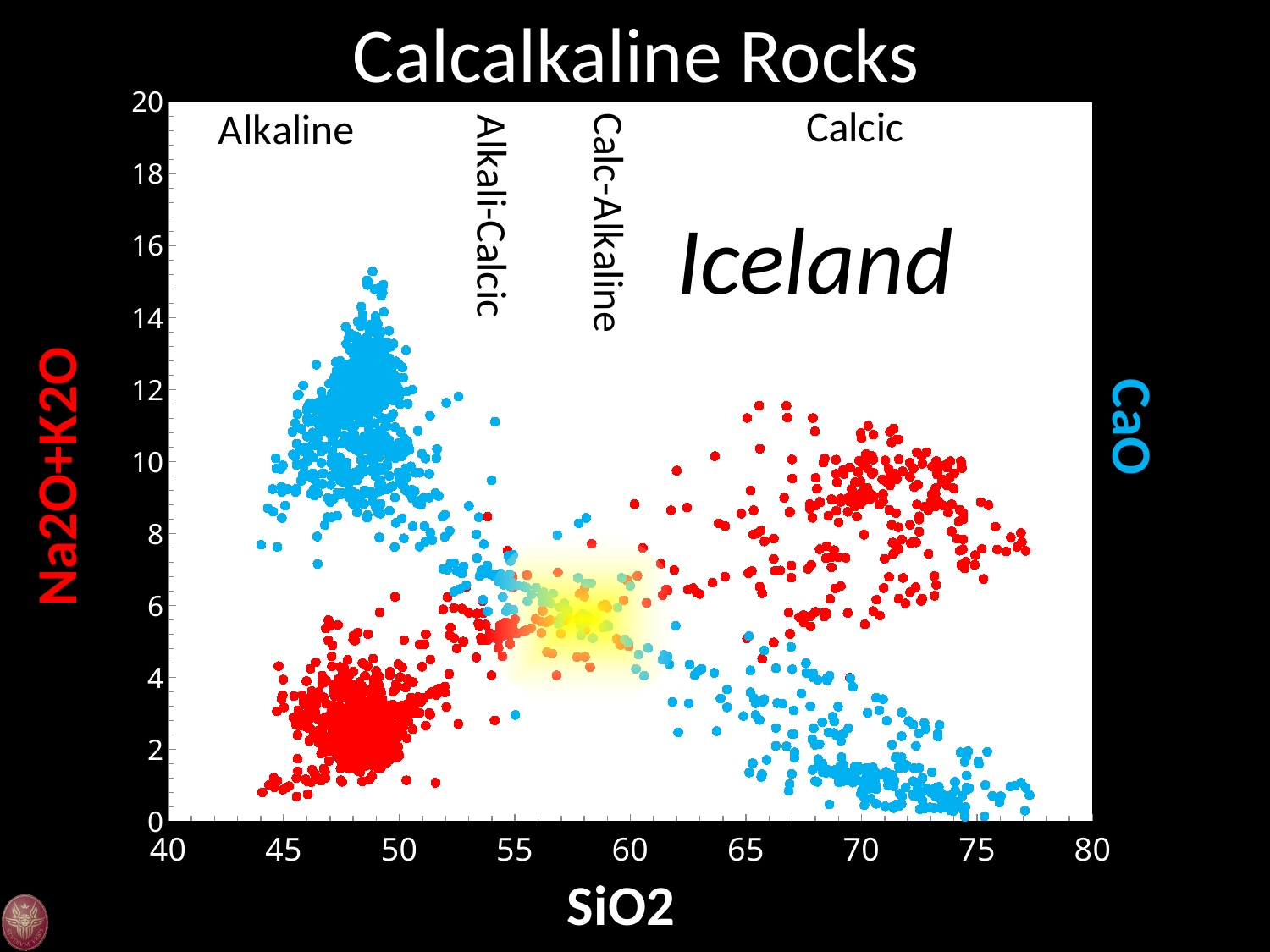
What colour are the CaO points on the chart? Blue Does Na2O+K2O rise or fall as SiO2 increases along the x axis? Rise Does CaO rise or fall as SiO2 increases along the x axis? Fall What is the title of the chart? Calcalkaline Rocks At SiO2 of 75, is the CaO value greater or less than 4? less At SiO2 of 48, are the CaO values greater or less than 8? greater At SiO2 of 48, are the Na2O+K2O values greater or less than 6? less At SiO2 of 48, which series has the larger values, CaO or Na2O+K2O? CaO What kind of chart is shown on the slide? Scatter plot How many data series are plotted on the chart? 2 At SiO2 of 70, which series has the larger values, CaO or Na2O+K2O? Na2O+K2O